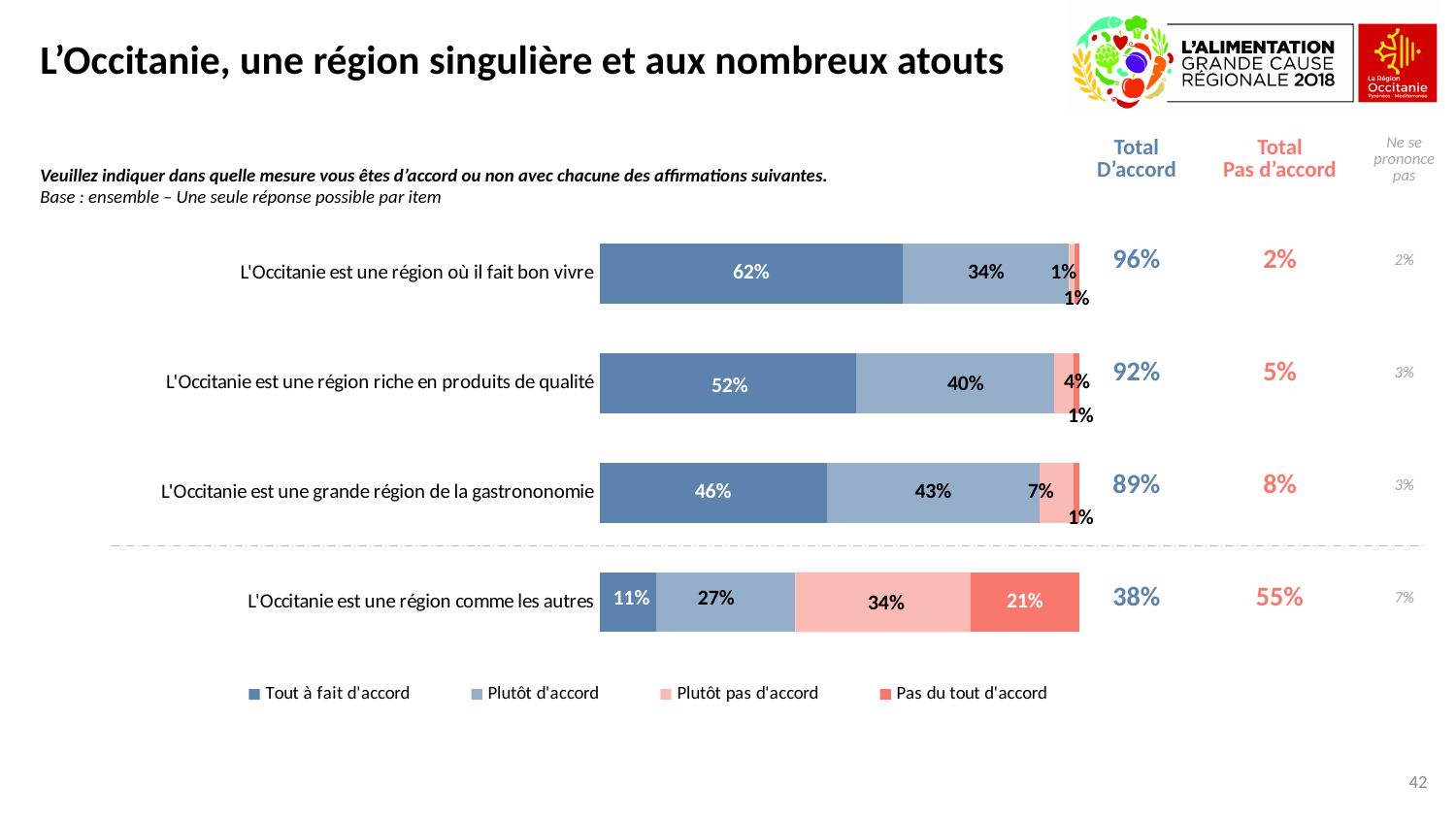
What percentage of respondents answered "Tout à fait d'accord" to "L'Occitanie est une région où il fait bon vivre"? 62% What is the "Pas du tout d'accord" value for "L'Occitanie est une région comme les autres"? 21% Which statement has the highest "Tout à fait d'accord" share? L'Occitanie est une région où il fait bon vivre What is the "Total D'accord" value shown for "L'Occitanie est une grande région de la gastrononomie"? 89% Which statement has the lowest "Tout à fait d'accord" share? L'Occitanie est une région comme les autres Which statement has the larger "Plutôt pas d'accord" share: "L'Occitanie est une grande région de la gastrononomie" or "L'Occitanie est une région riche en produits de qualité"? L'Occitanie est une grande région de la gastrononomie What is the "Plutôt d'accord" value for "L'Occitanie est une grande région de la gastrononomie"? 43% What type of chart is shown on the slide? Stacked bar chart What is the difference in "Plutôt d'accord" between "L'Occitanie est une région riche en produits de qualité" and "L'Occitanie est une région comme les autres"? 13 percentage points What is the sum of the four labelled segments for "L'Occitanie est une région comme les autres"? 93% How many response categories does the legend list? 4 How many statements are shown in the chart? 4